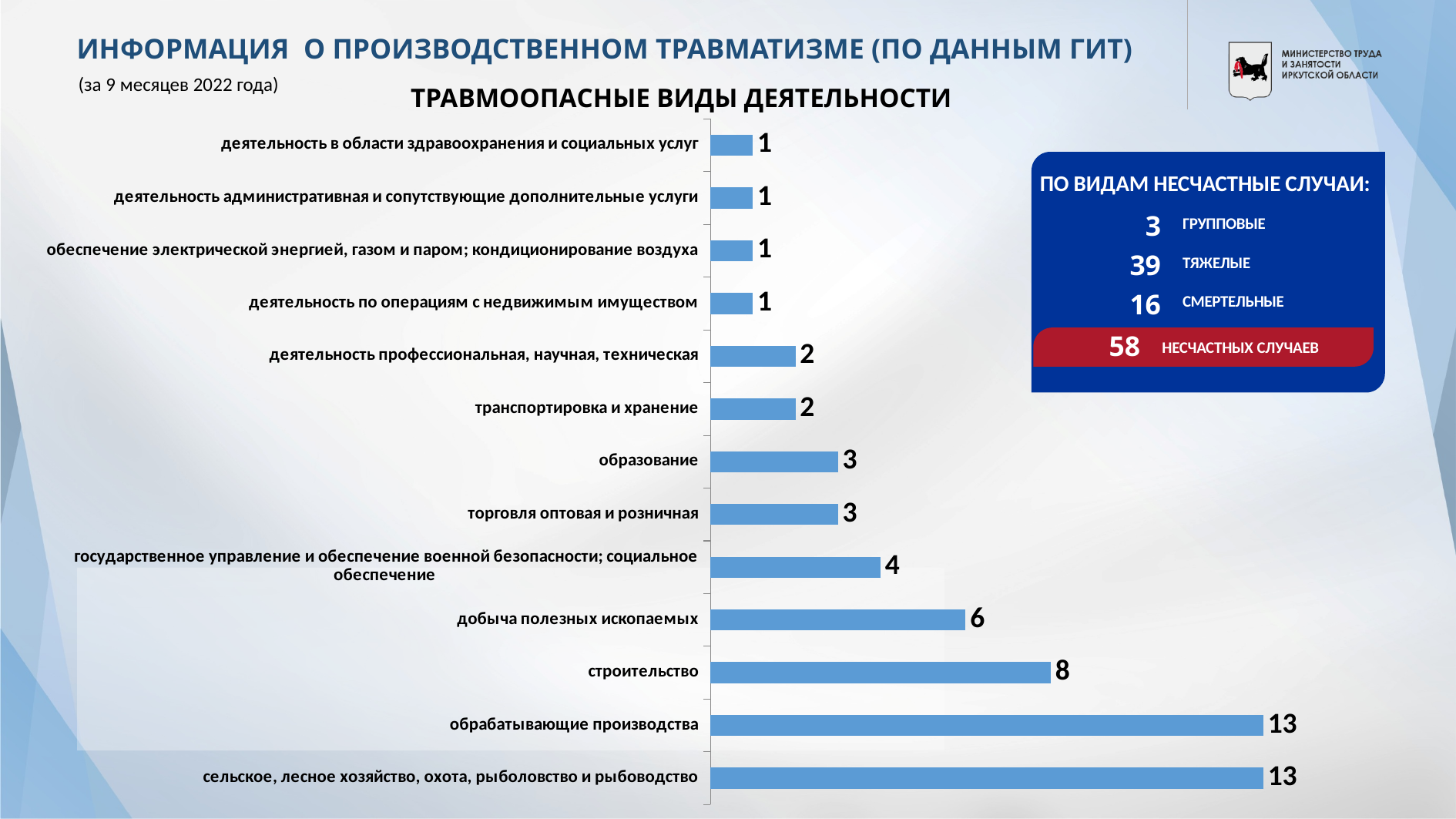
What is the title of the chart? ТРАВМООПАСНЫЕ ВИДЫ ДЕЯТЕЛЬНОСТИ What is the value for образование? 3 How many categories (types of activity) are shown in the chart? 13 Which two categories share the highest value in the chart? сельское, лесное хозяйство, охота, рыболовство и рыбоводство and обрабатывающие производства What type of chart is shown on the slide? bar chart What is the value for государственное управление и обеспечение военной безопасности; социальное обеспечение? 4 What is the value for обрабатывающие производства? 13 What is the value for добыча полезных ископаемых? 6 What is the difference between the values for строительство and добыча полезных ископаемых? 2 Which is larger: the value for торговля оптовая и розничная or the value for деятельность профессиональная, научная, техническая? торговля оптовая и розничная What is the value for строительство? 8 What is the value for транспортировка и хранение? 2